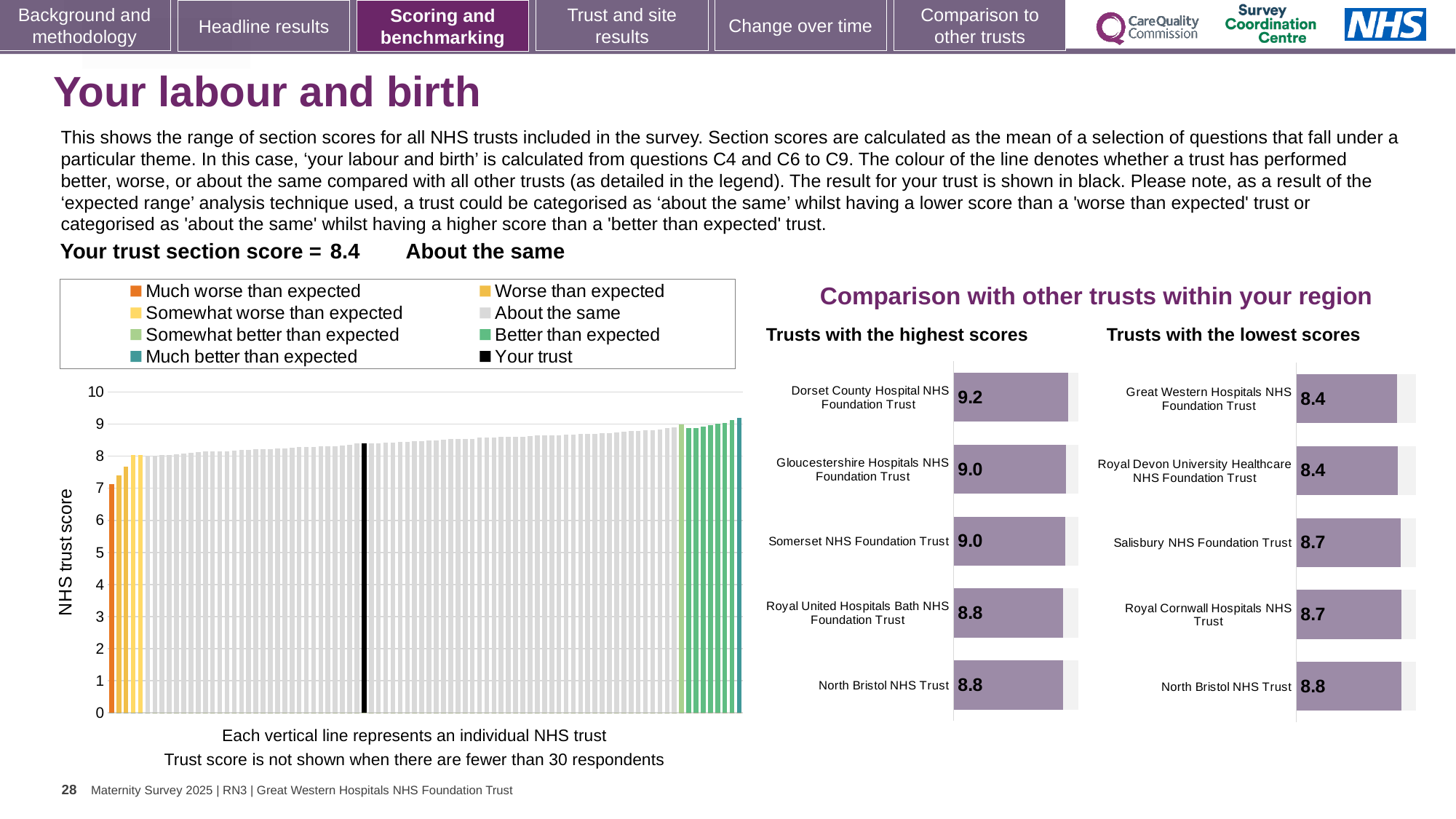
What is the y-axis title of the left-hand chart of all NHS trusts? NHS trust score In the 'Trusts with the lowest scores' chart, which trust has the highest score? North Bristol NHS Trust In the 'Trusts with the highest scores' chart, which trust has the highest score? Dorset County Hospital NHS Foundation Trust In the 'Trusts with the highest scores' chart, which has the larger score: Somerset NHS Foundation Trust or Royal United Hospitals Bath NHS Foundation Trust? Somerset NHS Foundation Trust In the 'Trusts with the highest scores' chart, what is the score for Dorset County Hospital NHS Foundation Trust? 9.2 How many entries does the legend of the left-hand chart of all NHS trusts list? 8 In the 'Trusts with the lowest scores' chart, what is the score for Salisbury NHS Foundation Trust? 8.7 What kind of chart is the left-hand chart showing the scores of all NHS trusts? Bar chart In the 'Trusts with the lowest scores' chart, what is the score for Great Western Hospitals NHS Foundation Trust? 8.4 In the 'Trusts with the highest scores' chart, what is the difference between the scores of Dorset County Hospital NHS Foundation Trust and North Bristol NHS Trust? 0.4 How many trusts are shown in the 'Trusts with the highest scores' chart? 5 In the left-hand chart of all NHS trusts, do the scores rise or fall from left to right? Rise